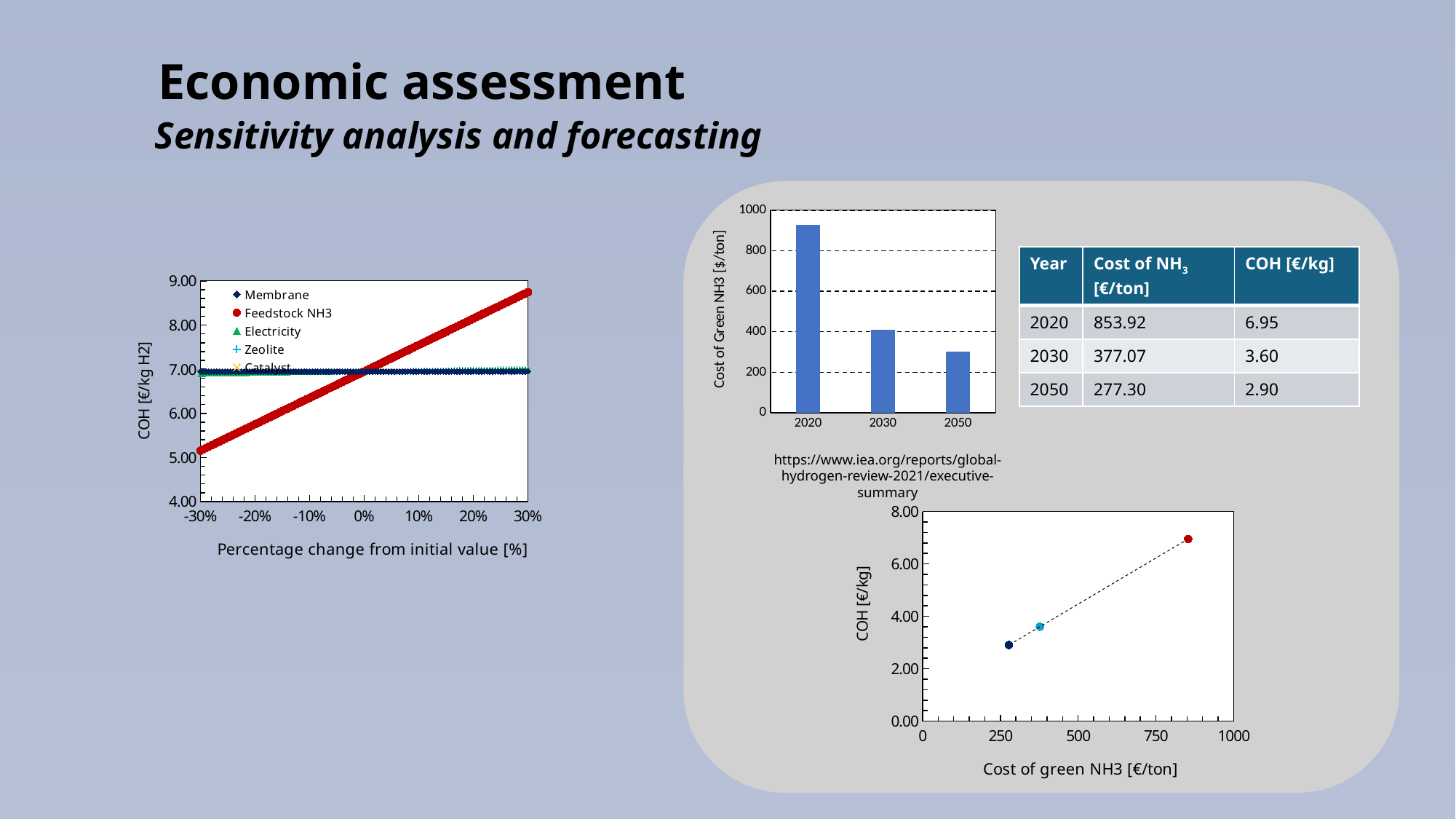
In the left sensitivity chart, which series shows the strongest change in COH across the percentage range? Feedstock NH3 In the top-right bar chart of Cost of Green NH3, is the value for 2050 greater or less than 400? less What kind of chart is the top-right chart showing Cost of Green NH3 [$/ton] by year? bar chart In the top-right bar chart of Cost of Green NH3, which year has the lowest value? 2050 In the left sensitivity chart, is the COH for Feedstock NH3 at +30% greater or less than 8.00? greater In the left sensitivity chart, does the COH for Feedstock NH3 rise or fall as the percentage change increases from -30% to 30%? rise In the top-right bar chart of Cost of Green NH3, which year has the highest value? 2020 In the left sensitivity chart (COH vs percentage change from initial value), how many series does the legend list? 5 In the top-right bar chart of Cost of Green NH3, do the values rise or fall from 2020 to 2050? fall In the top-right bar chart of Cost of Green NH3, how many years are shown? 3 In the bottom-right chart of COH vs cost of green NH3, how many data points are plotted? 3 In the top-right bar chart of Cost of Green NH3, is the value for 2020 greater or less than 800? greater